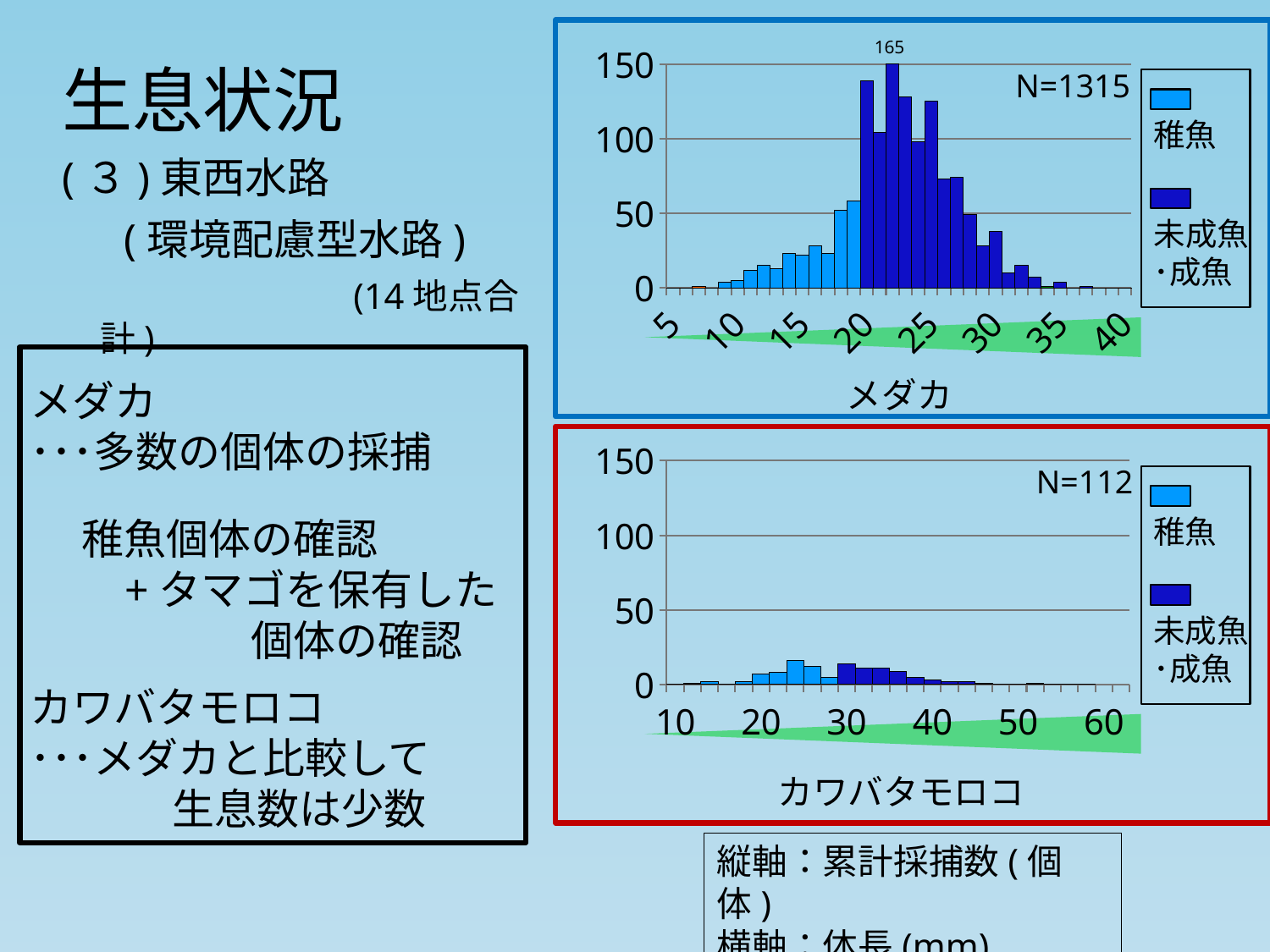
In the メダカ chart, do the values rise or fall along the x axis from 25 to 35? fall What N value is shown on the カワバタモロコ chart? N=112 In the カワバタモロコ chart, which is larger, the value at body length 25 or at body length 50? 25 In the メダカ chart, is the value for body length 30 greater or less than 50? less How many series does the legend of the メダカ chart list? 2 In the メダカ chart, is the value for body length 15 greater or less than 50? less In the カワバタモロコ chart, is the value for body length 25 greater or less than 50? less In the メダカ chart, do the values rise or fall along the x axis from 10 to 20? rise In the メダカ chart, what is the highest value shown by a data label? 165 What N value is shown on the メダカ chart? N=1315 Which chart has the higher peak value, メダカ or カワバタモロコ? メダカ What kind of chart is the メダカ chart? bar chart